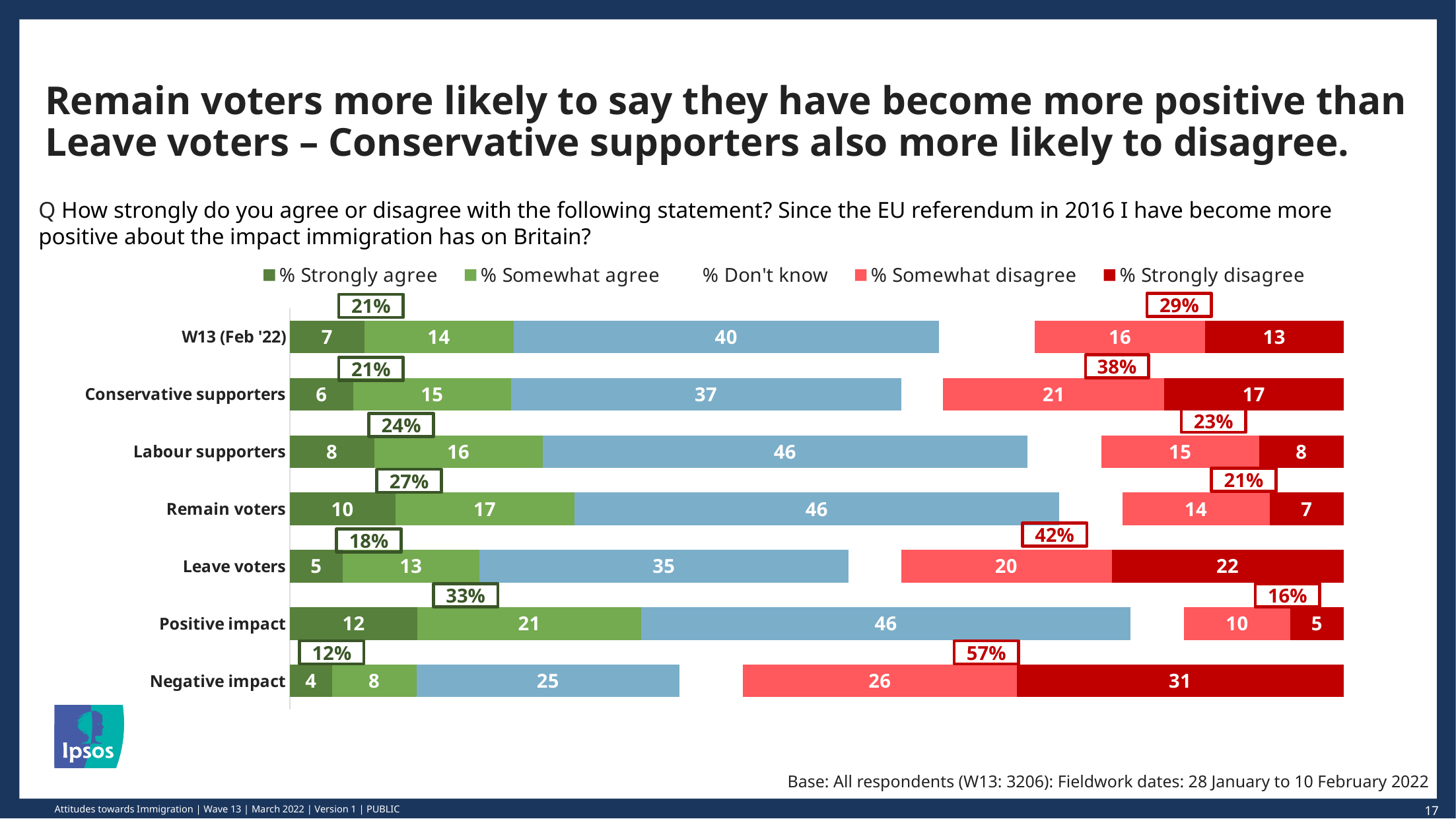
Which has the larger % Somewhat disagree value, Conservative supporters or Labour supporters? Conservative supporters How many categories are shown on the chart? 7 What is the % Strongly disagree value for Negative impact? 31 What colour represents % Strongly disagree in the legend? Dark red What is the combined agree percentage shown above the bar for Leave voters? 18% What is the combined disagree percentage shown above the bar for Negative impact? 57% Which category has the highest % Strongly agree value? Positive impact What kind of chart is shown on the slide? Stacked bar chart How many series does the legend list? 5 What is the difference between the % Strongly disagree values for Leave voters and Remain voters? 15